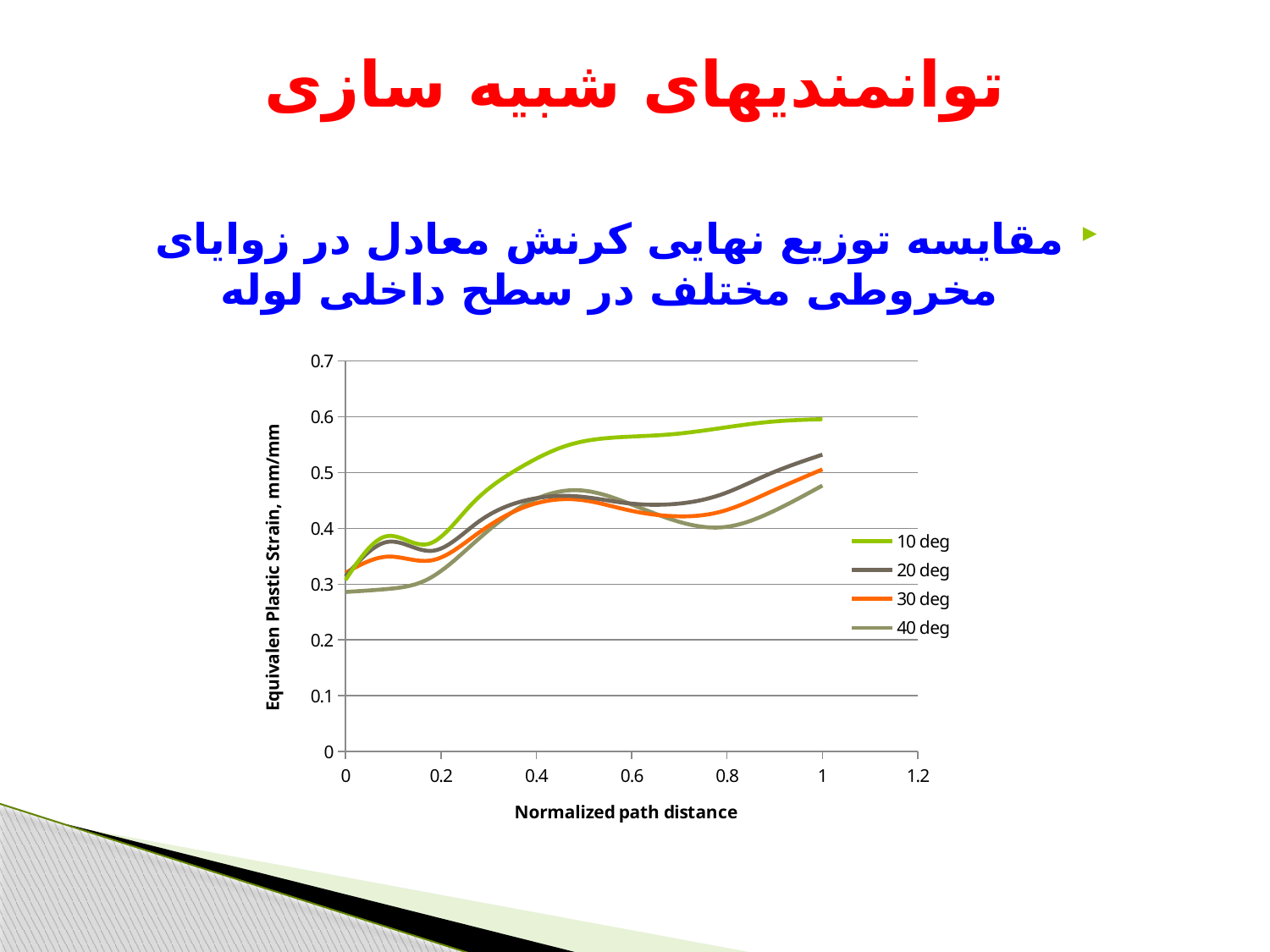
At a normalized path distance of 1, which is larger: the 10 deg series or the 40 deg series? 10 deg What are the series names listed in the legend? 10 deg, 20 deg, 30 deg, 40 deg Is the value of the 40 deg series at a normalized path distance of 1 greater or less than 0.5? less Is the value of the 20 deg series at a normalized path distance of 1 greater or less than 0.5? greater Which series has the highest value at a normalized path distance of 1? 10 deg How many series does the legend list? 4 What is the title of the x axis? Normalized path distance Is the value of the 10 deg series at a normalized path distance of 0.6 greater or less than 0.5? greater What kind of chart is shown on the slide? line chart Does the 10 deg series generally rise or fall as the normalized path distance increases from 0 to 1? rise Which series has the lowest value at a normalized path distance of 0? 40 deg